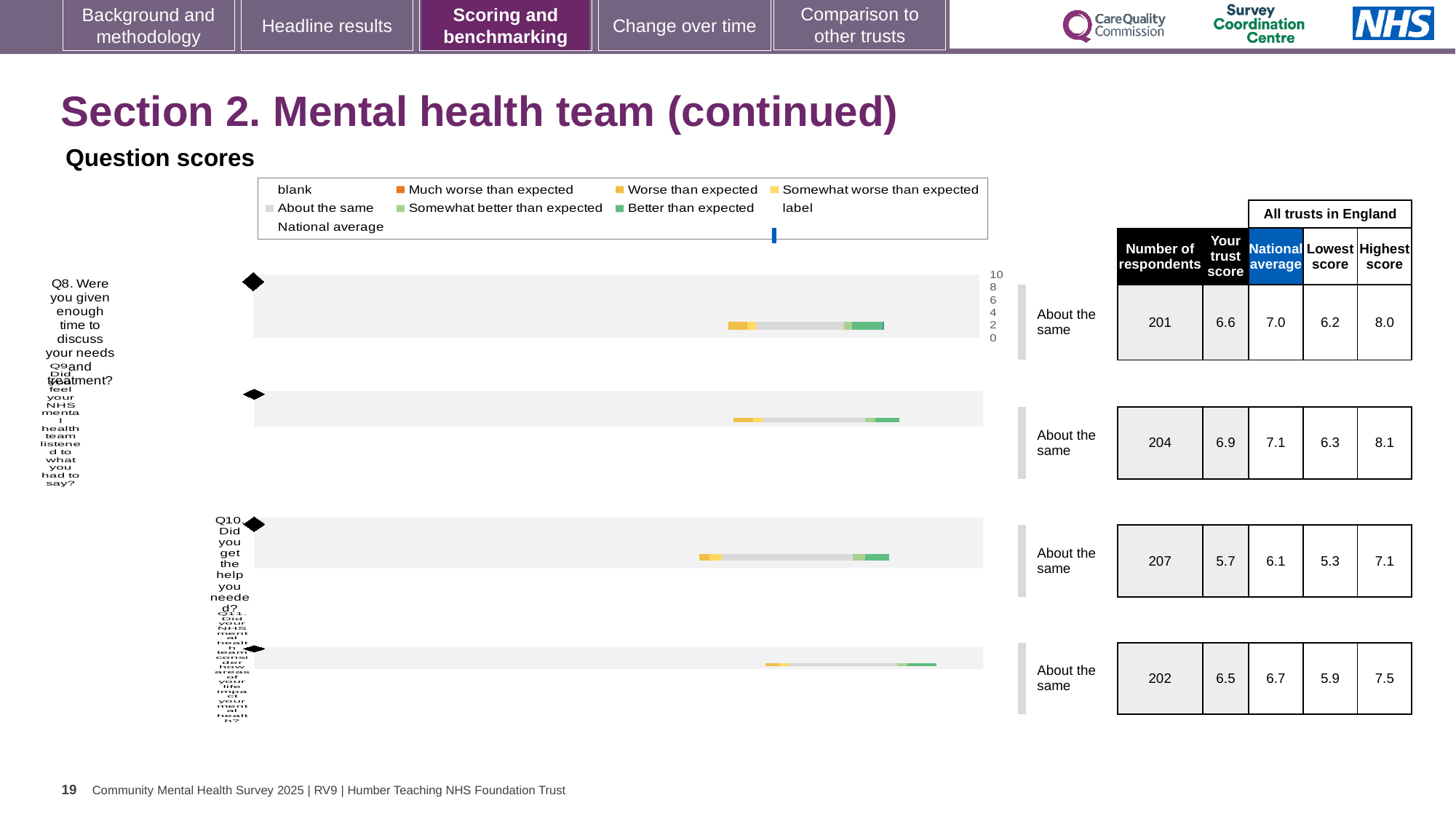
In the legend, what colour represents 'Better than expected'? green For the Q10 chart (did you get the help you needed), what is the number of respondents? 207 Is the trust score for the Q9 chart larger or smaller than the trust score for the Q11 chart? larger For the Q11 chart (areas of life impacting mental health), what is the highest score across all trusts in England? 7.5 In the legend, what colour represents 'Much worse than expected'? orange What is the highest value shown on the axis of the Q8 chart? 10 For the Q9 chart (team listened to what you had to say), what is the national average shown in the table? 7.1 How many question charts (Q8 to Q11) are shown on the slide? 4 What is the difference between the national average and the trust score for the Q10 chart? 0.4 For the Q8 chart (enough time to discuss needs and treatment), what is the trust score shown in the table? 6.6 Which question chart has the lowest trust score in the table: Q8, Q9, Q10 or Q11? Q10 What kind of chart is used for the question scores on this slide? bar chart